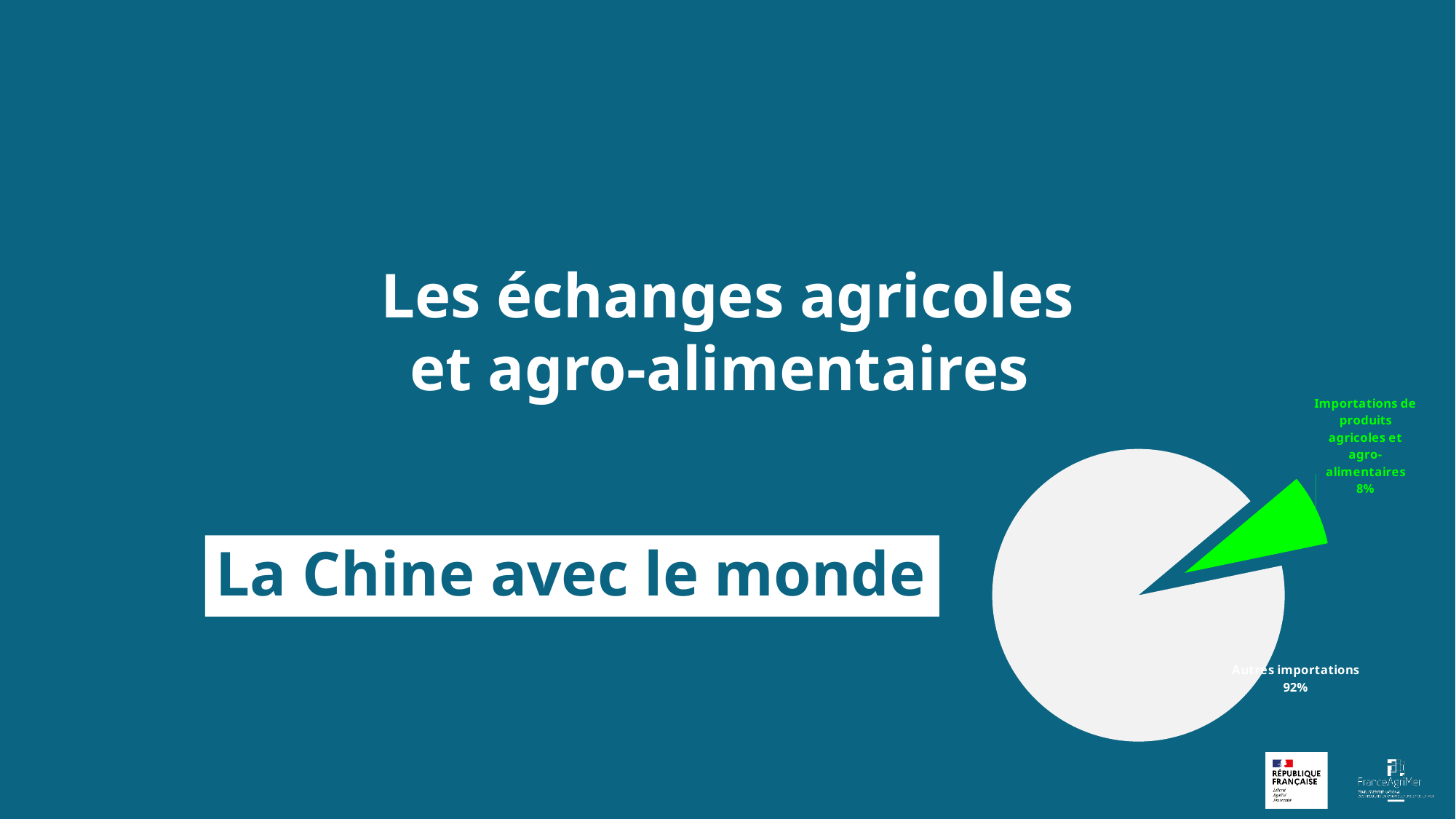
Which slice of the pie is the smallest? Importations de produits agricoles et agro-alimentaires What share of the pie is labelled "Autres importations"? 92% Which is larger: the "Autres importations" slice or the "Importations de produits agricoles et agro-alimentaires" slice? Autres importations Which slice of the pie is the largest? Autres importations What share of the pie is labelled "Importations de produits agricoles et agro-alimentaires"? 8% What colour is the "Importations de produits agricoles et agro-alimentaires" slice? green What is the difference in percentage points between the "Autres importations" slice and the "Importations de produits agricoles et agro-alimentaires" slice? 84 percentage points What do the two slices of the pie add up to? 100% How many slices does the pie chart have? 2 What colour is the "Autres importations" slice? white What kind of chart is shown on the slide? pie chart Is the share for "Importations de produits agricoles et agro-alimentaires" greater or less than 10%? less